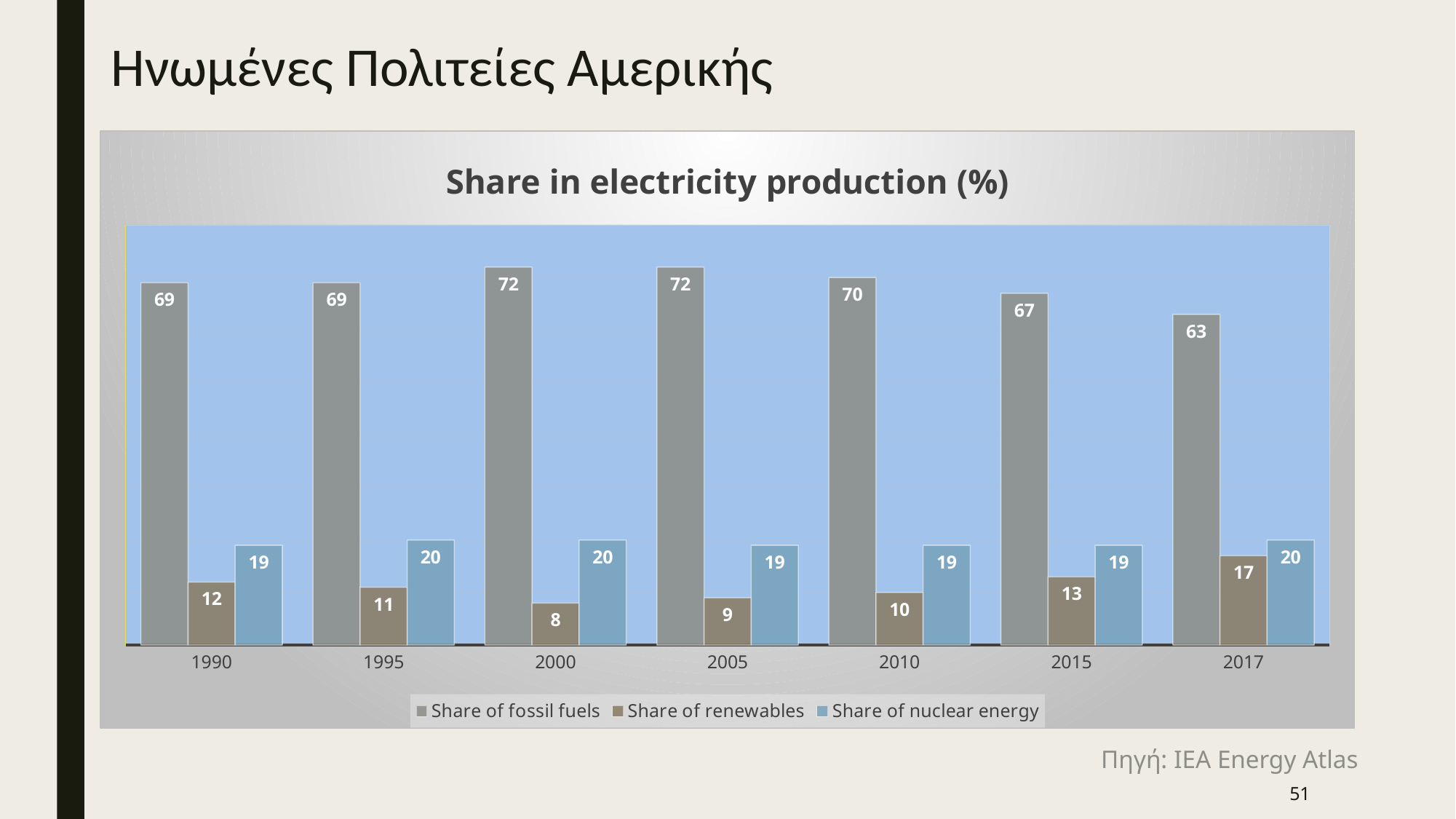
Which is larger in 2015: the share of renewables or the share of nuclear energy? Share of nuclear energy In which year is the share of fossil fuels lowest? 2017 What is the share of fossil fuels in 2000? 72 What is the share of renewables in 2017? 17 What kind of chart is shown on the slide? Bar chart How many series does the legend list? 3 What is the share of nuclear energy in 1990? 19 What is the title of the chart? Share in electricity production (%) What is the difference between the share of fossil fuels in 2000 and in 2017? 9 In which year is the share of renewables highest? 2017 How many years are shown on the x axis? 7 In which year is the share of renewables lowest? 2000